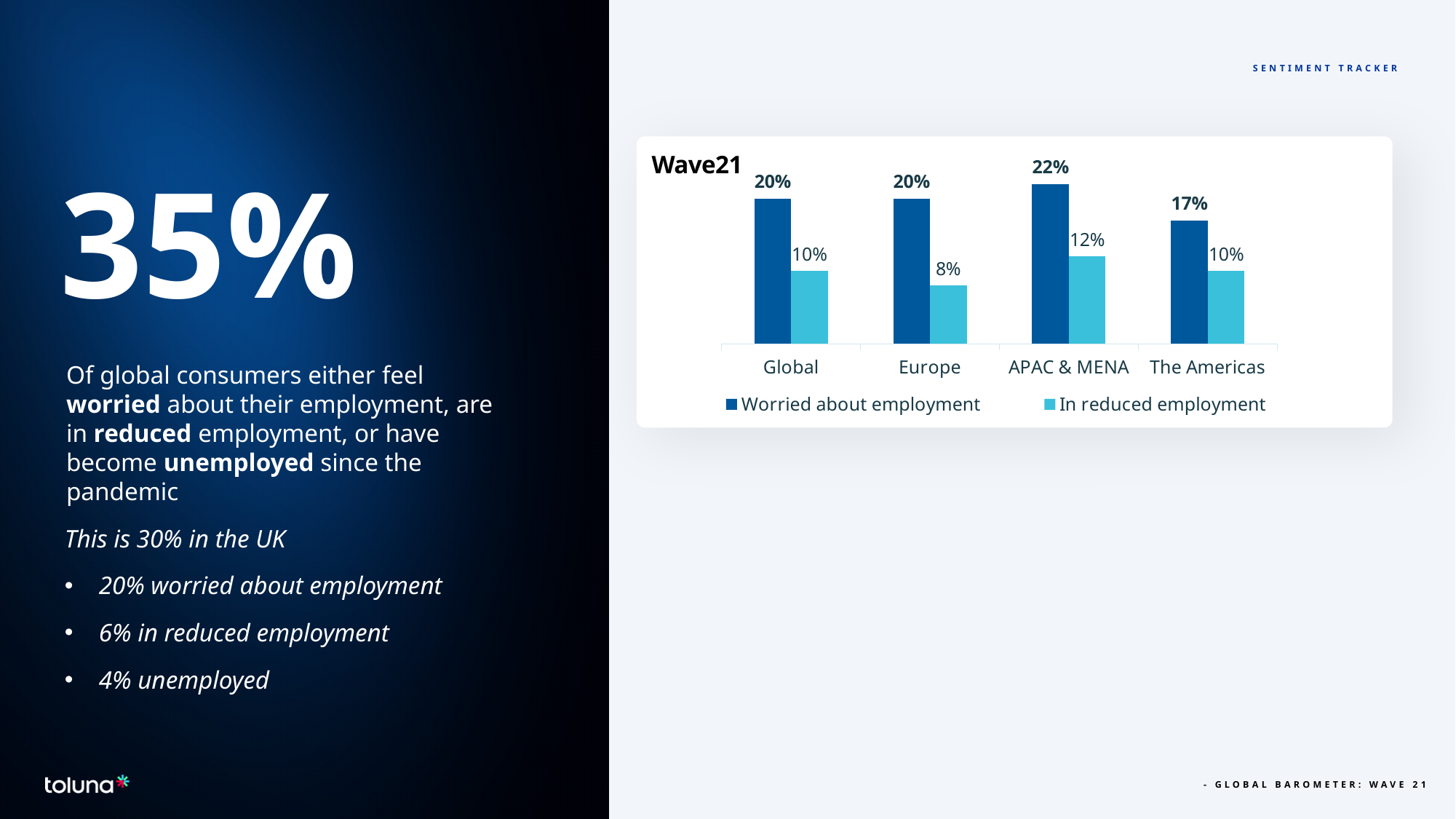
What is the title of the chart? Wave21 What is the value for 'In reduced employment' in Europe? 8% What kind of chart is shown on the slide? Bar chart How many regions are shown on the x axis of the chart? 4 What is the value for 'Worried about employment' in The Americas? 17% What is the value for 'Worried about employment' in APAC & MENA? 22% How many series does the chart legend list? 2 Which region has the highest value for 'Worried about employment'? APAC & MENA Which is larger: 'In reduced employment' in APAC & MENA or in The Americas? APAC & MENA What is the difference between 'Worried about employment' and 'In reduced employment' in APAC & MENA? 10% What is the value for 'In reduced employment' for Global? 10% Which region has the lowest value for 'In reduced employment'? Europe